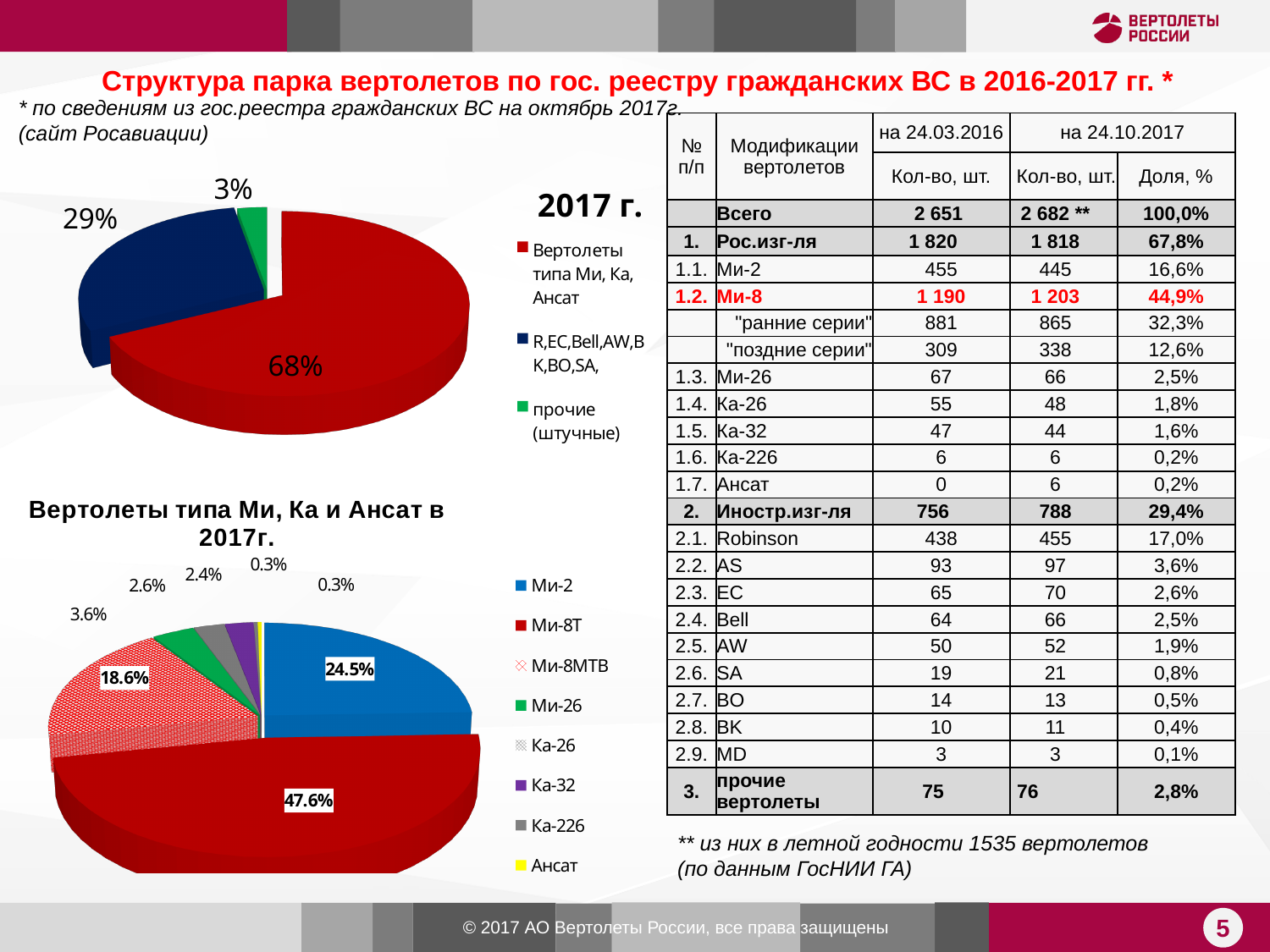
In the pie chart titled "Вертолеты типа Ми, Ка и Ансат в 2017г.", which category has the largest share? Ми-8Т In the pie chart titled "2017 г.", what is the difference in percentage points between the largest slice and the "R,EC,Bell,AW,BK,BO,SA" slice? 39 In the pie chart titled "Вертолеты типа Ми, Ка и Ансат в 2017г.", what share is shown for Ми-8Т? 47.6% In the pie chart titled "2017 г.", which slice is the smallest? прочие (штучные) In the pie chart titled "Вертолеты типа Ми, Ка и Ансат в 2017г.", what share is shown for Ми-2? 24.5% In the pie chart titled "2017 г.", what share is shown for the slice "R,EC,Bell,AW,BK,BO,SA"? 29% In the pie chart titled "Вертолеты типа Ми, Ка и Ансат в 2017г.", what share is shown for Ми-8МТВ? 18.6% How many slices does the pie chart titled "2017 г." have? 3 In the pie chart titled "Вертолеты типа Ми, Ка и Ансат в 2017г.", which is larger: the share for Ми-2 or the share for Ми-8МТВ? Ми-2 In the pie chart titled "2017 г.", what share is shown for the slice "Вертолеты типа Ми, Ка, Ансат"? 68% What type of chart is the chart titled "Вертолеты типа Ми, Ка и Ансат в 2017г."? Pie chart How many categories does the legend of the pie chart titled "Вертолеты типа Ми, Ка и Ансат в 2017г." list? 8